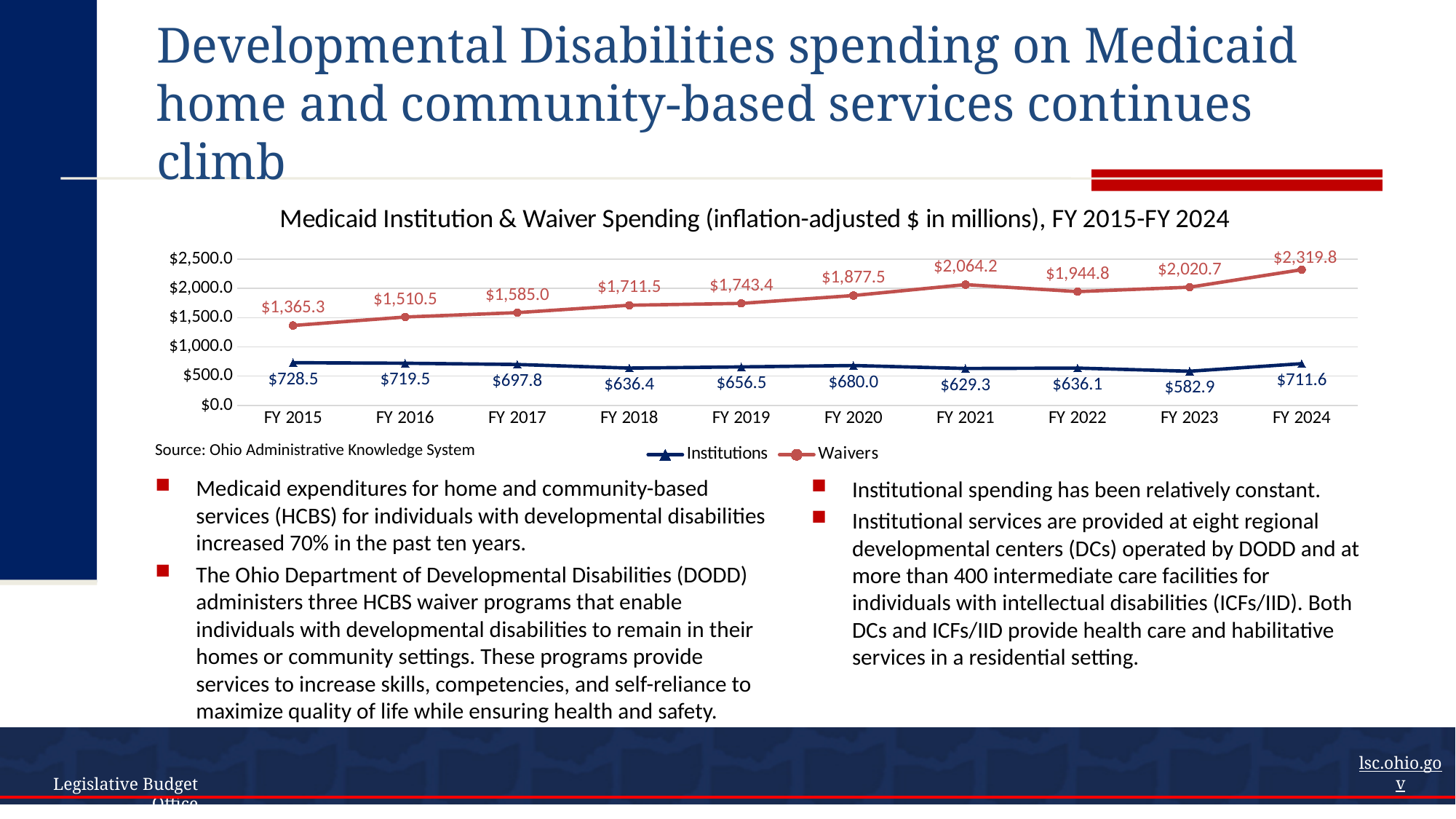
How many series does the legend list? 2 What is the difference between Waivers and Institutions spending in FY 2015? $636.8 How many fiscal years are shown on the x axis? 10 Does Waivers spending generally rise or fall from FY 2015 to FY 2024? Rise What kind of chart is shown on the slide? Line chart What is the source cited below the chart? Ohio Administrative Knowledge System In which fiscal year is Waivers spending highest? FY 2024 What is the Institutions spending value for FY 2018? $636.4 In which fiscal year is Institutions spending lowest? FY 2023 Is the Waivers value for FY 2021 greater or less than $2,000.0? greater Which is larger, Institutions spending in FY 2015 or in FY 2024? FY 2015 What is the Waivers spending value for FY 2024? $2,319.8